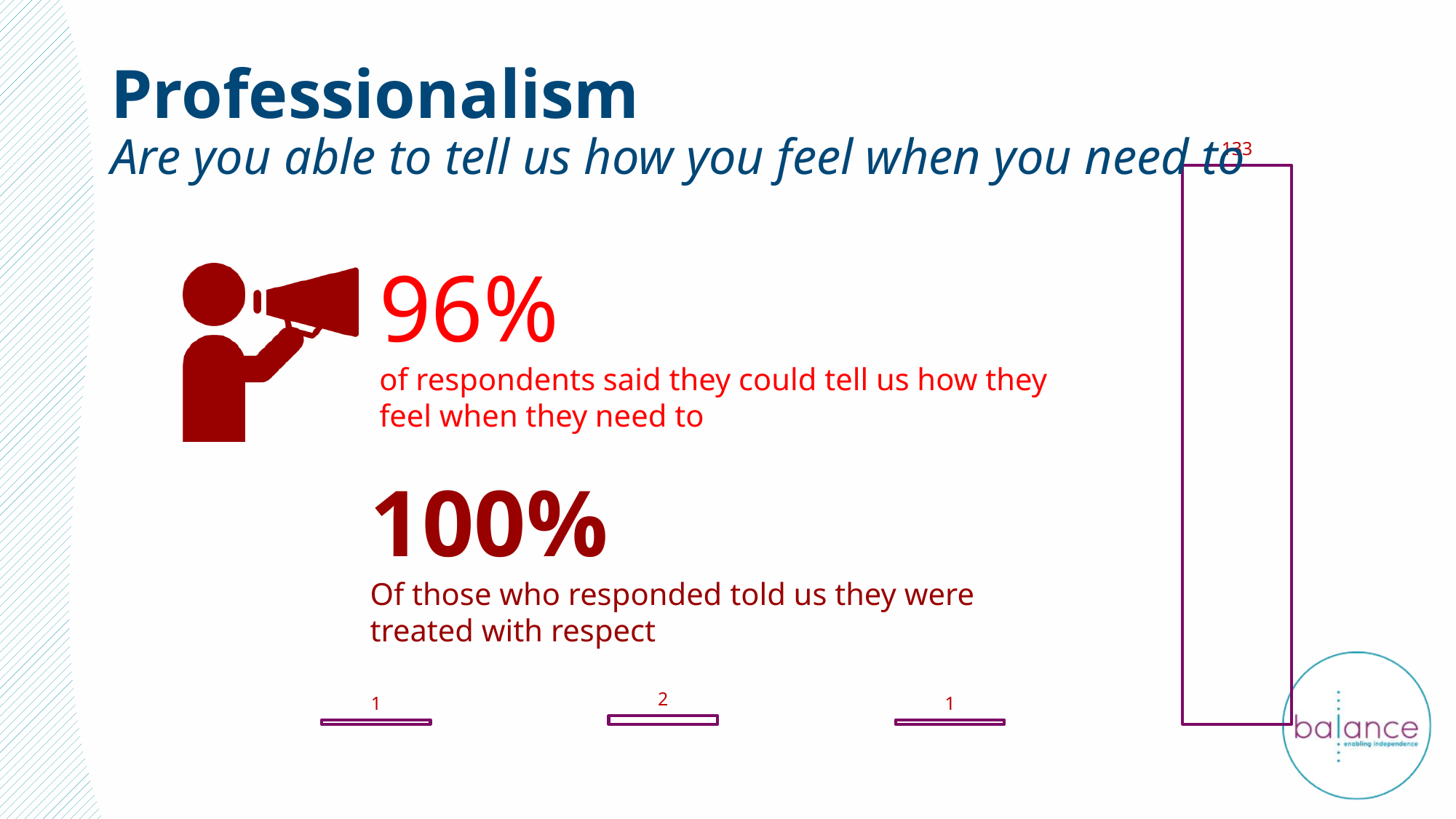
What is the sum of all four bar values shown in the chart? 137 What is the data label on the tallest bar in the chart? 133 What is the value of the second bar from the left in the chart? 2 What kind of chart is shown on the slide? bar chart Which is larger in the chart: the second bar from the left or the rightmost bar? the rightmost bar What is the difference between the tallest bar (133) and the second bar (2) in the chart? 131 What is the value of the third bar from the left in the chart? 1 What is the value of the first (leftmost) bar in the chart? 1 What is the smallest data label shown on the chart? 1 How many bars does the chart on the slide have? 4 What is the value of the fourth (rightmost) bar in the chart? 133 What colour are the bar outlines in the chart? purple